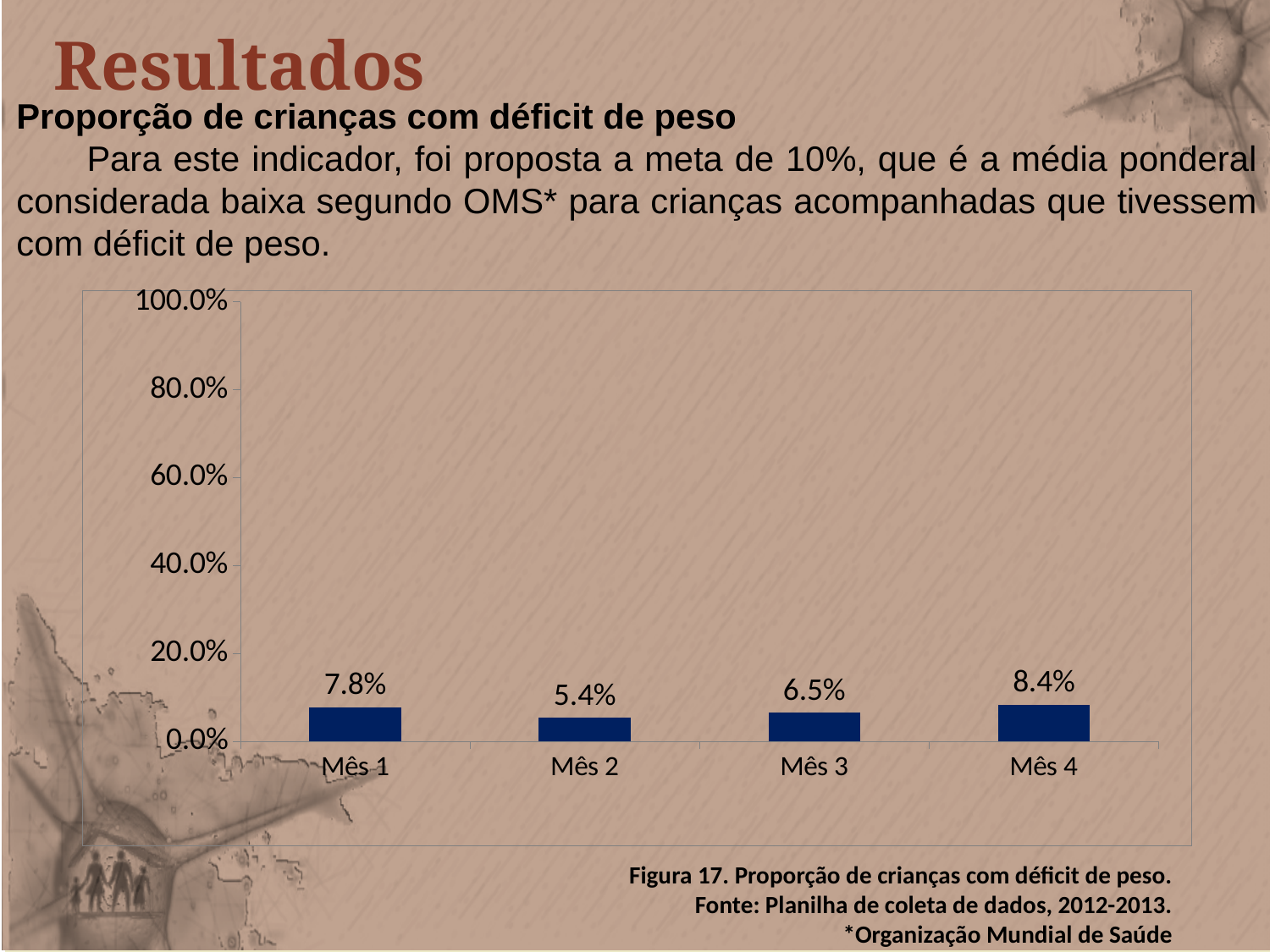
What is the figure caption below the chart? Figura 17. Proporção de crianças com déficit de peso. Which month has the lowest proportion of children with weight deficit? Mês 2 Is the value for Mês 4 greater or less than 20.0%? less What is the value for Mês 1? 7.8% What is the difference between the values for Mês 4 and Mês 2? 3.0% Which month has the highest proportion of children with weight deficit? Mês 4 How many months are shown on the x axis? 4 What kind of chart is shown on the slide? bar chart What is the value for Mês 3? 6.5% Which is larger, the value for Mês 1 or the value for Mês 3? Mês 1 What is the value for Mês 4? 8.4% What is the value for Mês 2? 5.4%